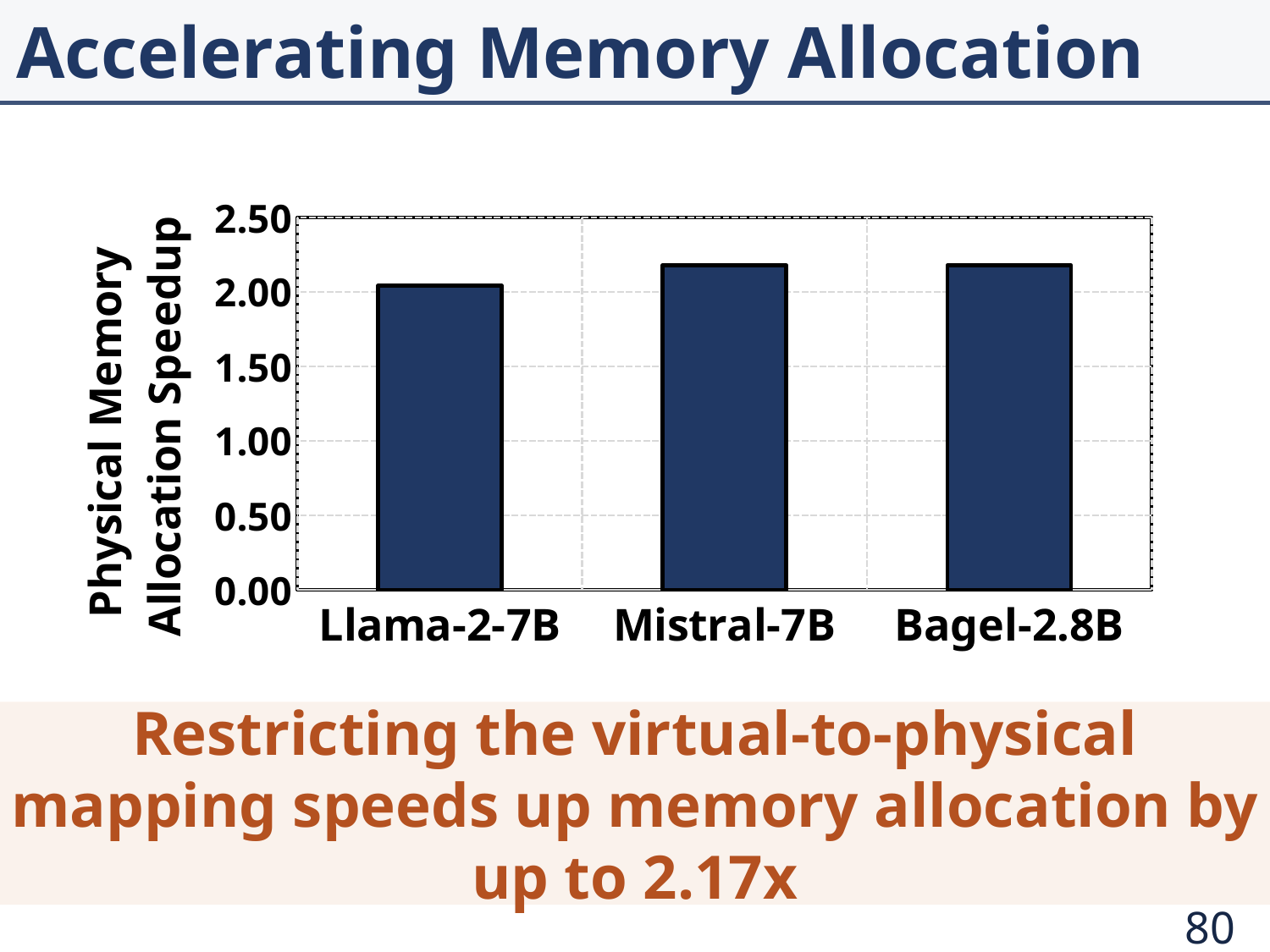
What kind of chart is shown on the slide? bar chart Which model has the lowest physical memory allocation speedup? Llama-2-7B Is the physical memory allocation speedup for Llama-2-7B greater or less than 1.50? greater Is the physical memory allocation speedup for Mistral-7B greater or less than 2.50? less How many models (categories) are plotted in the chart? 3 Which has the larger physical memory allocation speedup, Bagel-2.8B or Llama-2-7B? Bagel-2.8B What is the label of the y-axis of the chart? Physical Memory Allocation Speedup Is the physical memory allocation speedup for Bagel-2.8B greater or less than 2.00? greater What is the highest value shown on the y-axis of the chart? 2.50 Which has the larger physical memory allocation speedup, Llama-2-7B or Mistral-7B? Mistral-7B